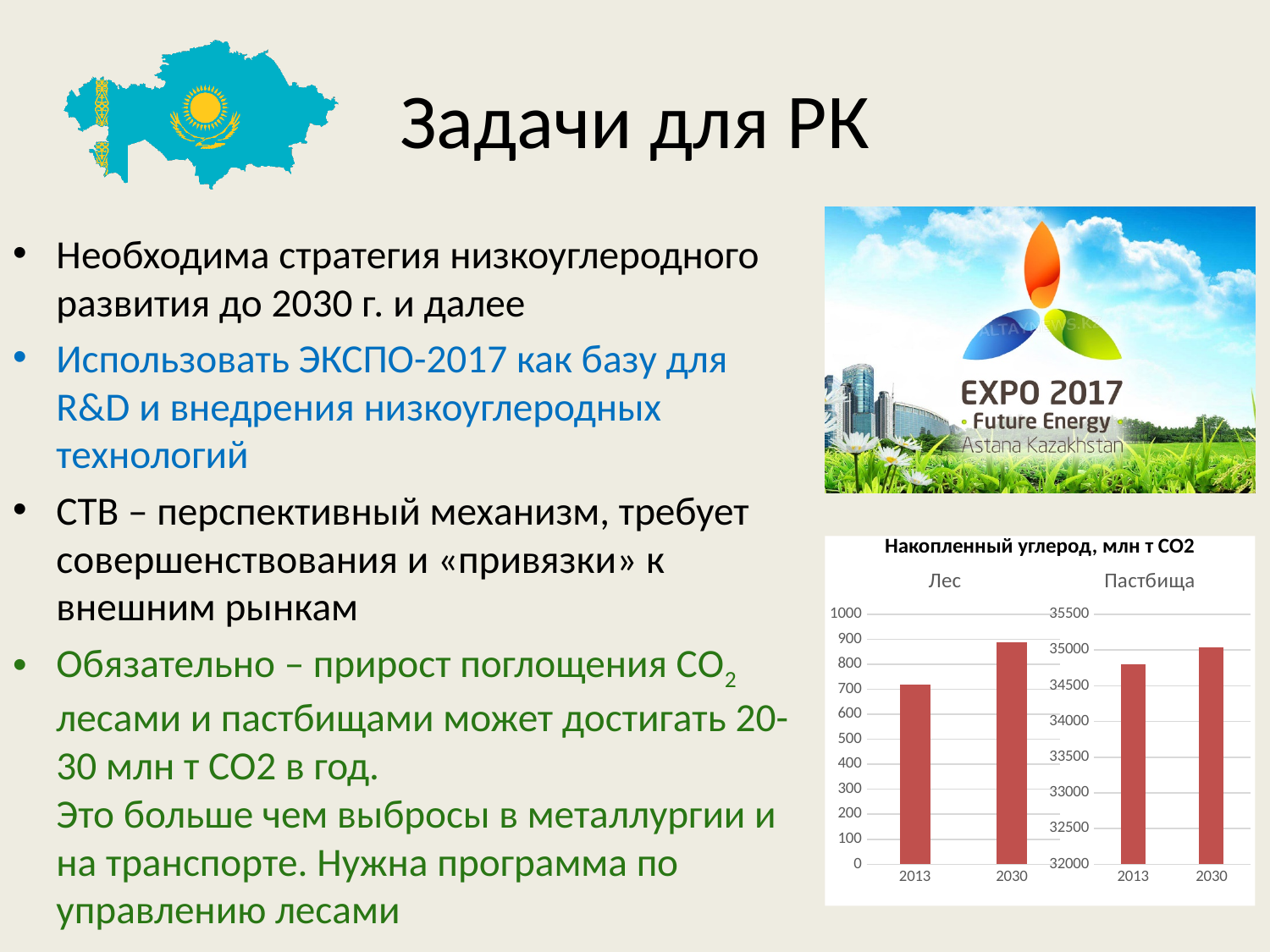
In the 'Пастбища' chart, is the value for 2013 greater or less than 34500? greater In the 'Лес' chart, is the value for 2013 greater or less than 800? less How many bars are in the 'Лес' chart? 2 In the 'Пастбища' chart, which year has the lower value? 2013 What colour are the bars in the 'Пастбища' chart? red What kind of chart is the 'Лес' chart? bar chart In the 'Лес' chart, which year has the higher value, 2013 or 2030? 2030 In the 'Лес' chart, is the value for 2030 greater or less than 800? greater Do the values in the 'Лес' chart rise or fall from 2013 to 2030? rise How many bars are in the 'Пастбища' chart? 2 What is the overall title above the two charts? Накопленный углерод, млн т CO2